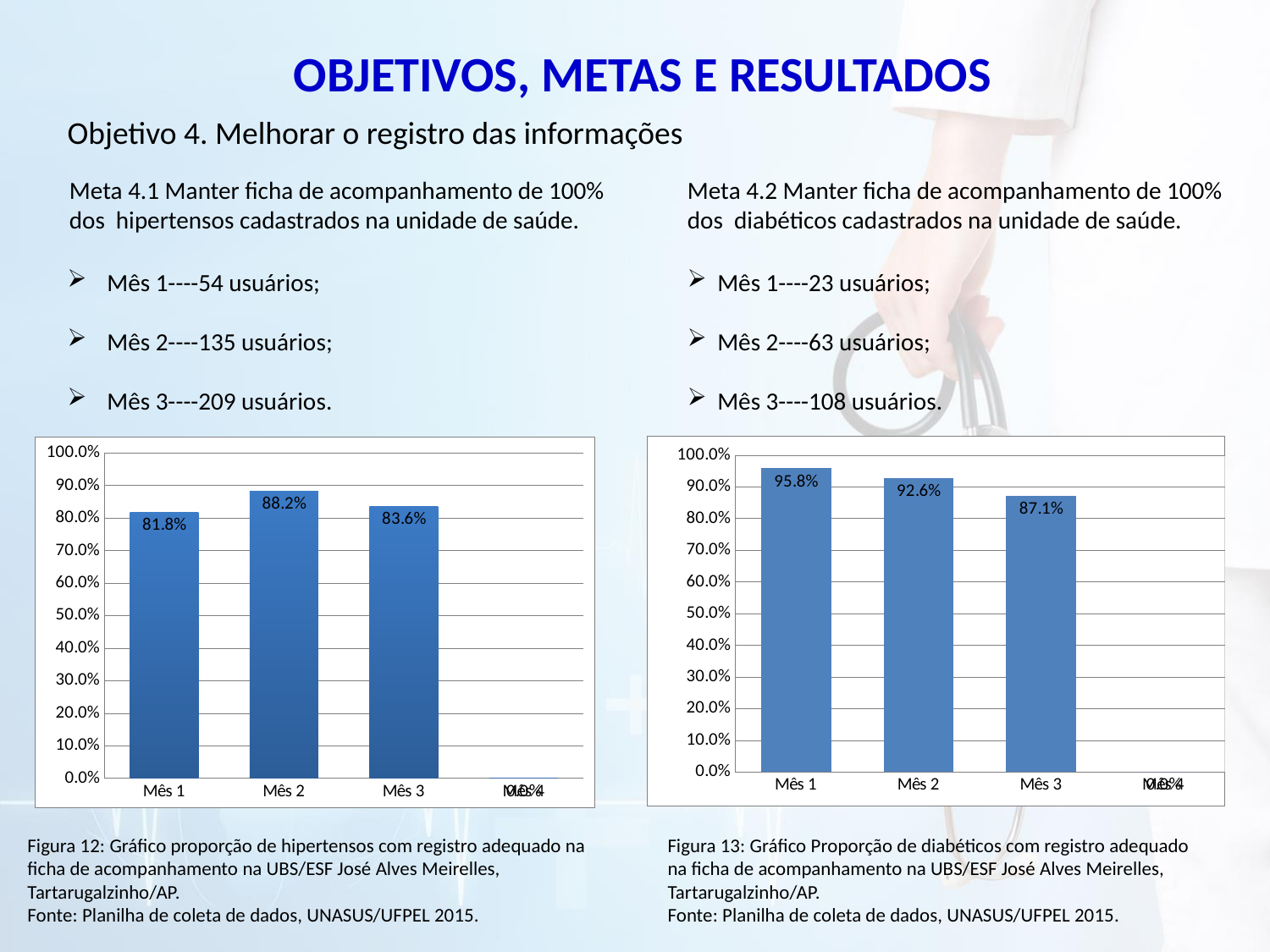
What type of chart is the left chart (hipertensos)? bar chart In the right chart (diabéticos), do the values rise or fall from Mês 1 to Mês 3? fall In the right chart (diabéticos), what is the value for Mês 3? 87.1% In the left chart (hipertensos), what is the value for Mês 2? 88.2% In the left chart (hipertensos), is the value for Mês 3 greater or less than 80.0%? greater In the left chart (hipertensos), what is the value for Mês 1? 81.8% In the left chart (hipertensos), which month has the highest value? Mês 2 In the left chart (hipertensos), what is the difference between the values for Mês 2 and Mês 1? 6.4% In the right chart (diabéticos), which month has the lowest non-zero value? Mês 3 In the right chart (diabéticos), what is the value for Mês 1? 95.8% In the right chart (diabéticos), what is the difference between the values for Mês 1 and Mês 3? 8.7% In the right chart (diabéticos), which is larger, the value for Mês 1 or Mês 2? Mês 1